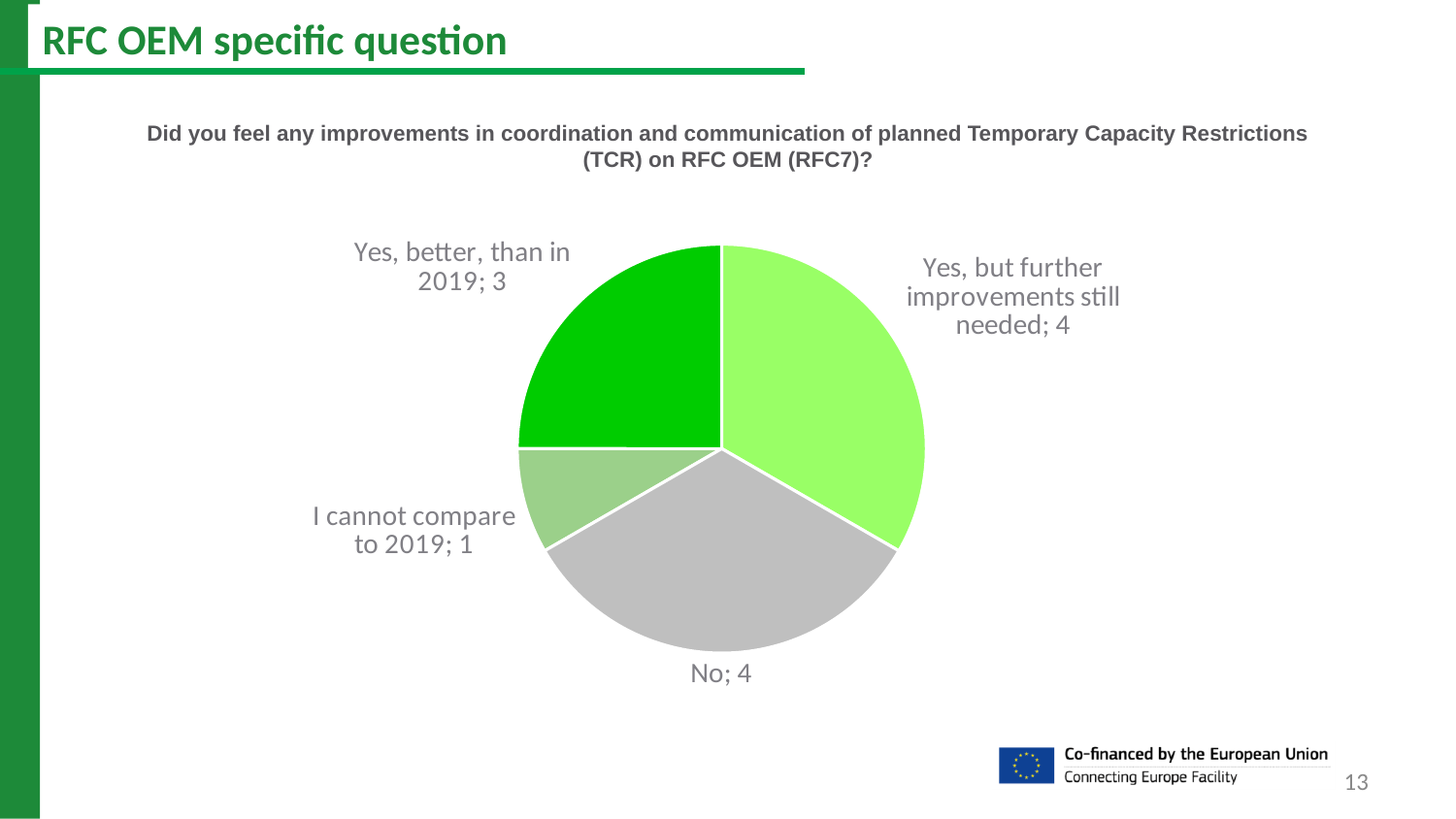
What is the total of all slices in the pie chart? 12 Which is larger: the value for "No" or the value for "Yes, better, than in 2019"? No What is the value for "I cannot compare to 2019"? 1 What is the difference between the value for "Yes, but further improvements still needed" and the value for "Yes, better, than in 2019"? 1 What is the value for "Yes, but further improvements still needed"? 4 Which response has the smallest slice in the pie chart? I cannot compare to 2019 What is the value for "No" in the pie chart? 4 What is the value for "Yes, better, than in 2019"? 3 What is the difference between the value for "No" and the value for "I cannot compare to 2019"? 3 How many slices does the pie chart have? 4 What type of chart is shown on the slide? pie chart What share of the pie does "Yes, better, than in 2019" represent? 25%